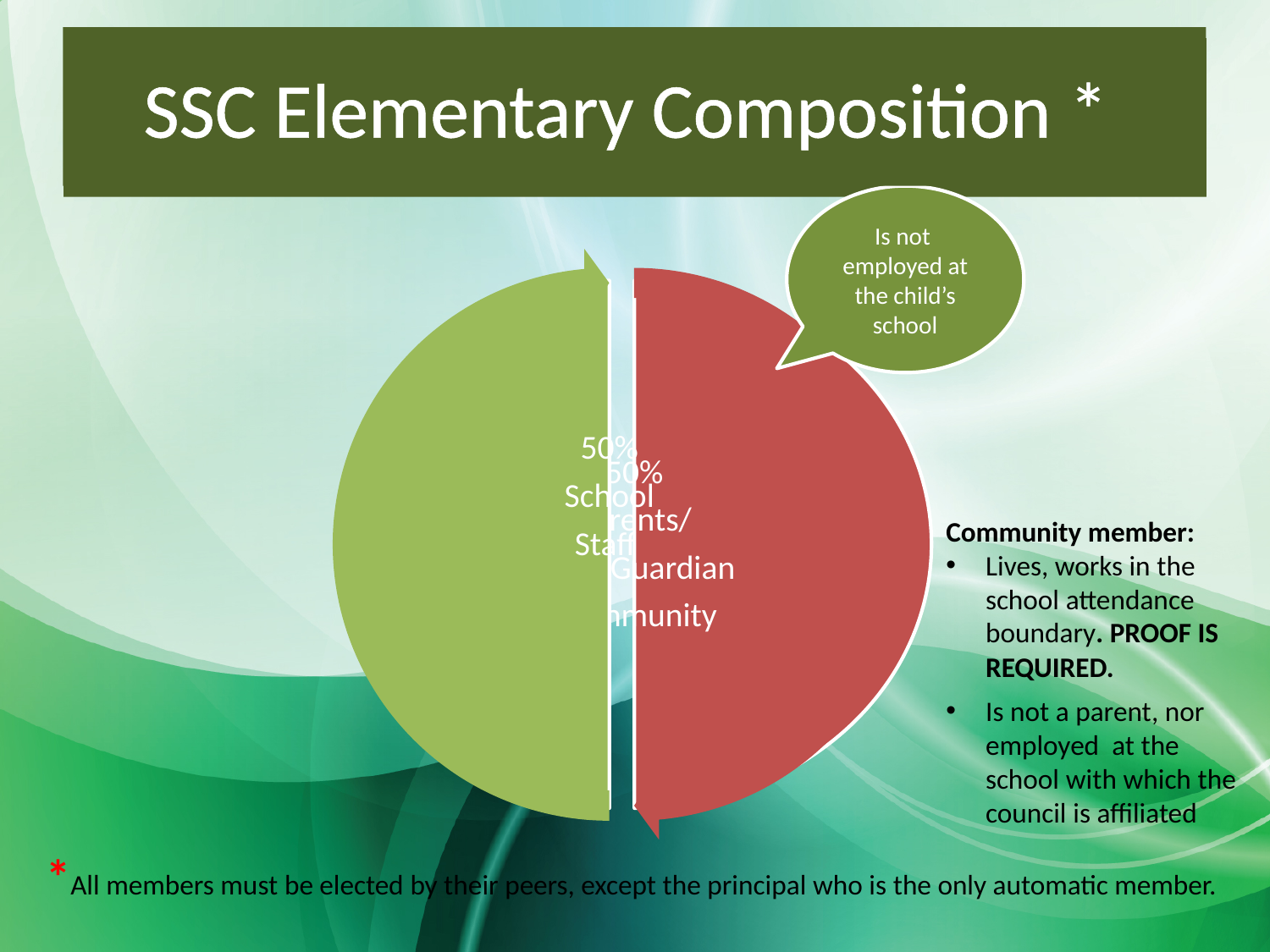
What colour is the School Staff slice of the pie chart? green What is the combined percentage of the two slices in the pie chart? 100% What percentage is shown for the Parents/Guardian Community slice? 50% Are the two slices of the pie chart equal in size? yes What share of the pie does the School Staff slice represent? 50% What percentage of the pie chart is labelled School Staff? 50% How many slices does the pie chart have? 2 What is the title of the slide containing the pie chart? SSC Elementary Composition What kind of chart is shown on the slide? pie chart